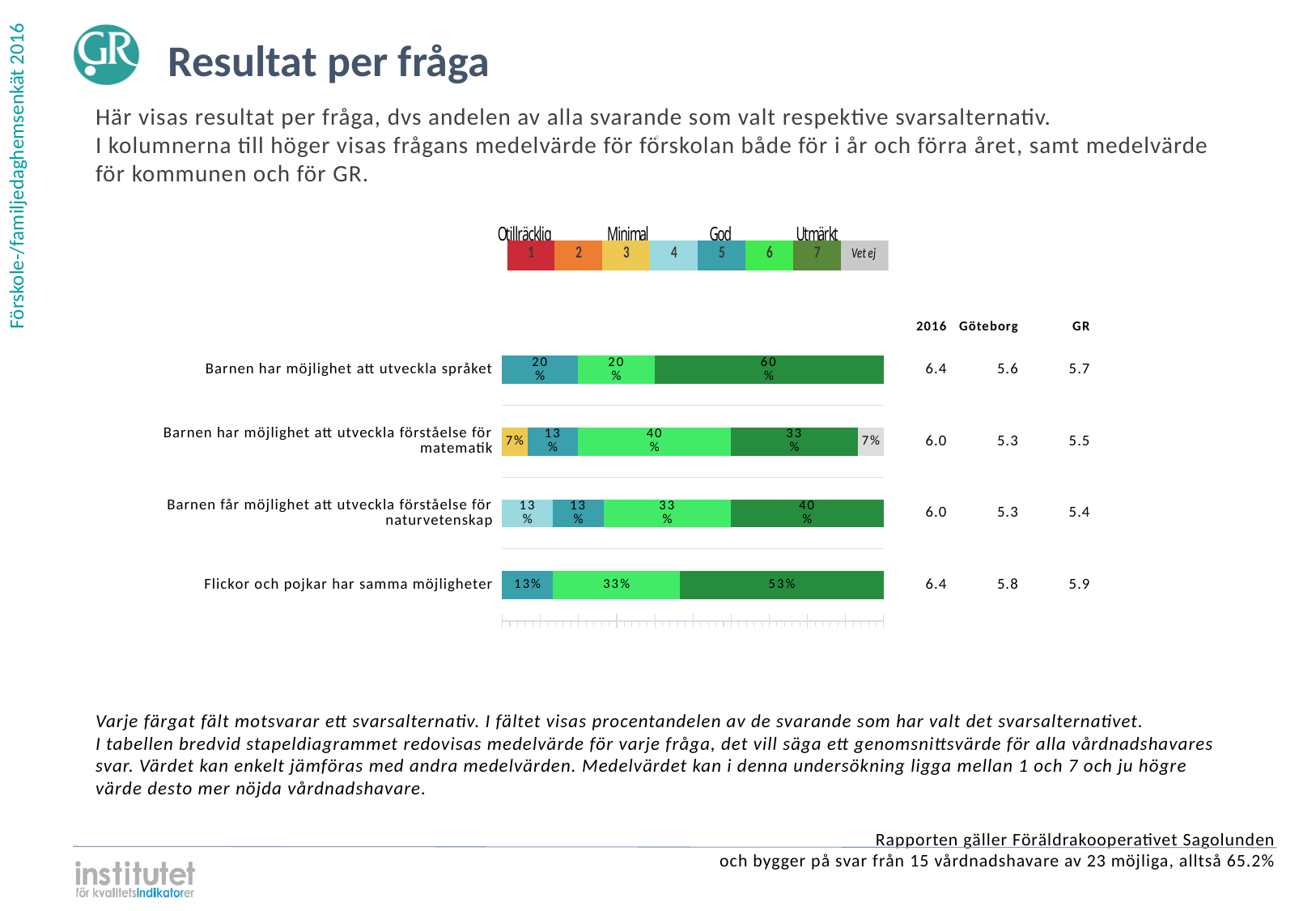
What is the difference between the share choosing 7 for 'Barnen har möjlighet att utveckla språket' (60%) and for 'Flickor och pojkar har samma möjligheter' (53%)? 7 percentage points What percentage chose 'Vet ej' for 'Barnen har möjlighet att utveckla förståelse för matematik'? 7% Which question has the highest Göteborg mean value? Flickor och pojkar har samma möjligheter What kind of chart is shown on the slide? Stacked bar chart How many questions (categories) are plotted in the bar chart? 4 What is the 2016 mean value for 'Barnen har möjlighet att utveckla förståelse för matematik'? 6.0 What percentage chose 4 (light blue) for 'Barnen får möjlighet att utveckla förståelse för naturvetenskap'? 13% Which question has the largest share of respondents choosing 7 (dark green)? Barnen har möjlighet att utveckla språket Which has a larger share choosing 6 (light green): 'Barnen har möjlighet att utveckla förståelse för matematik' or 'Barnen får möjlighet att utveckla förståelse för naturvetenskap'? Barnen har möjlighet att utveckla förståelse för matematik How many answer alternatives does the legend list (including 'Vet ej')? 8 What is the GR mean value for 'Flickor och pojkar har samma möjligheter'? 5.9 What percentage of respondents chose 7 (dark green) for 'Barnen har möjlighet att utveckla språket'? 60%